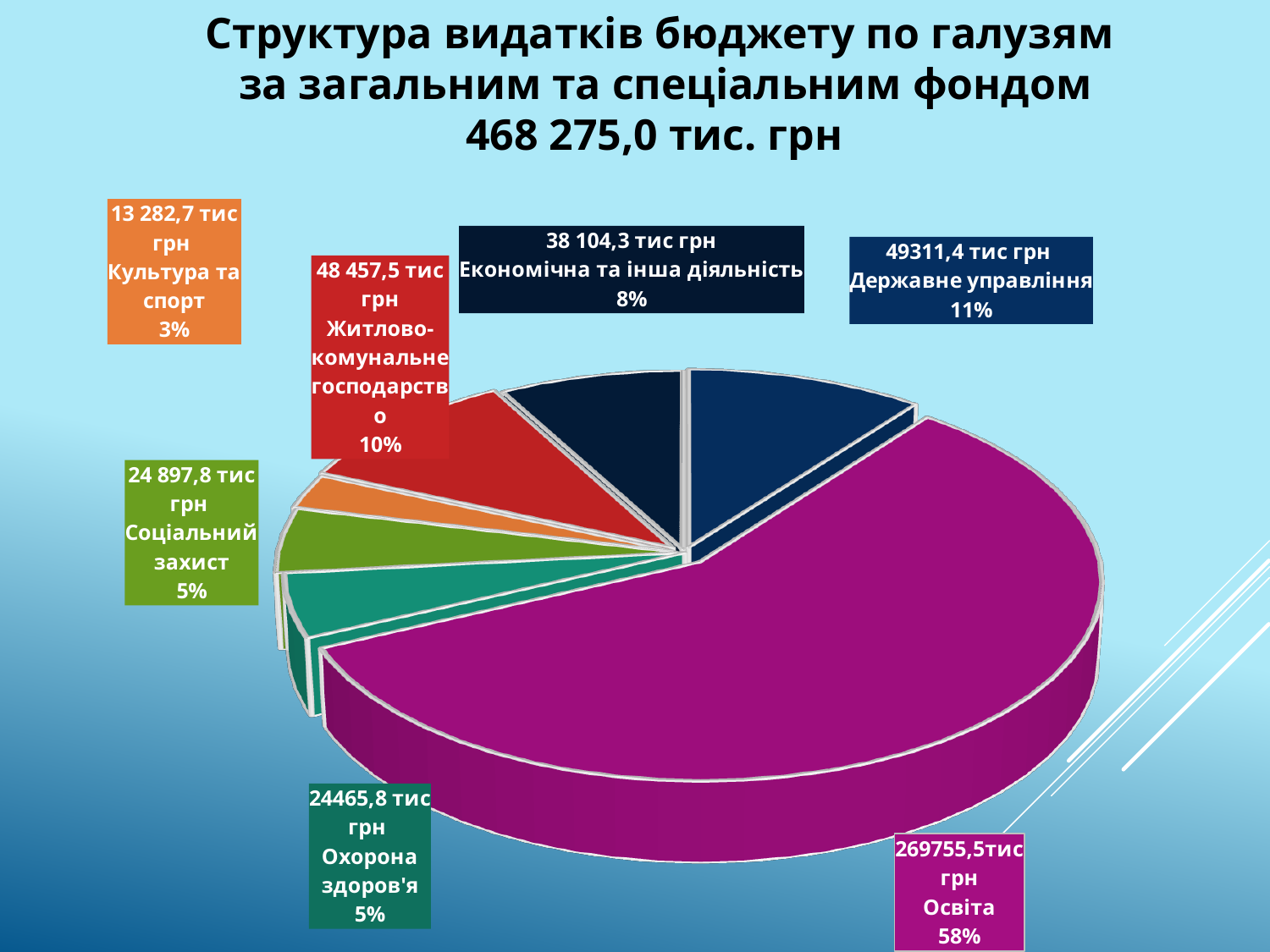
What is the value for Соціальний захист? 24 897,8 тис грн What is the value for Освіта? 269755,5 тис грн What kind of chart is shown on the slide? pie chart What is the difference in percentage points between the share for Освіта and the share for Державне управління? 47% What percentage is shown for Житлово-комунальне господарство? 10% What is the value for Державне управління? 49311,4 тис грн Which category has the smallest slice of the pie? Культура та спорт How many slices does the pie chart have? 7 What share of the pie does Освіта represent? 58% What total amount is stated in the chart title? 468 275,0 тис. грн Which category has the largest slice of the pie? Освіта Which is larger, the value for Державне управління or the value for Житлово-комунальне господарство? Державне управління